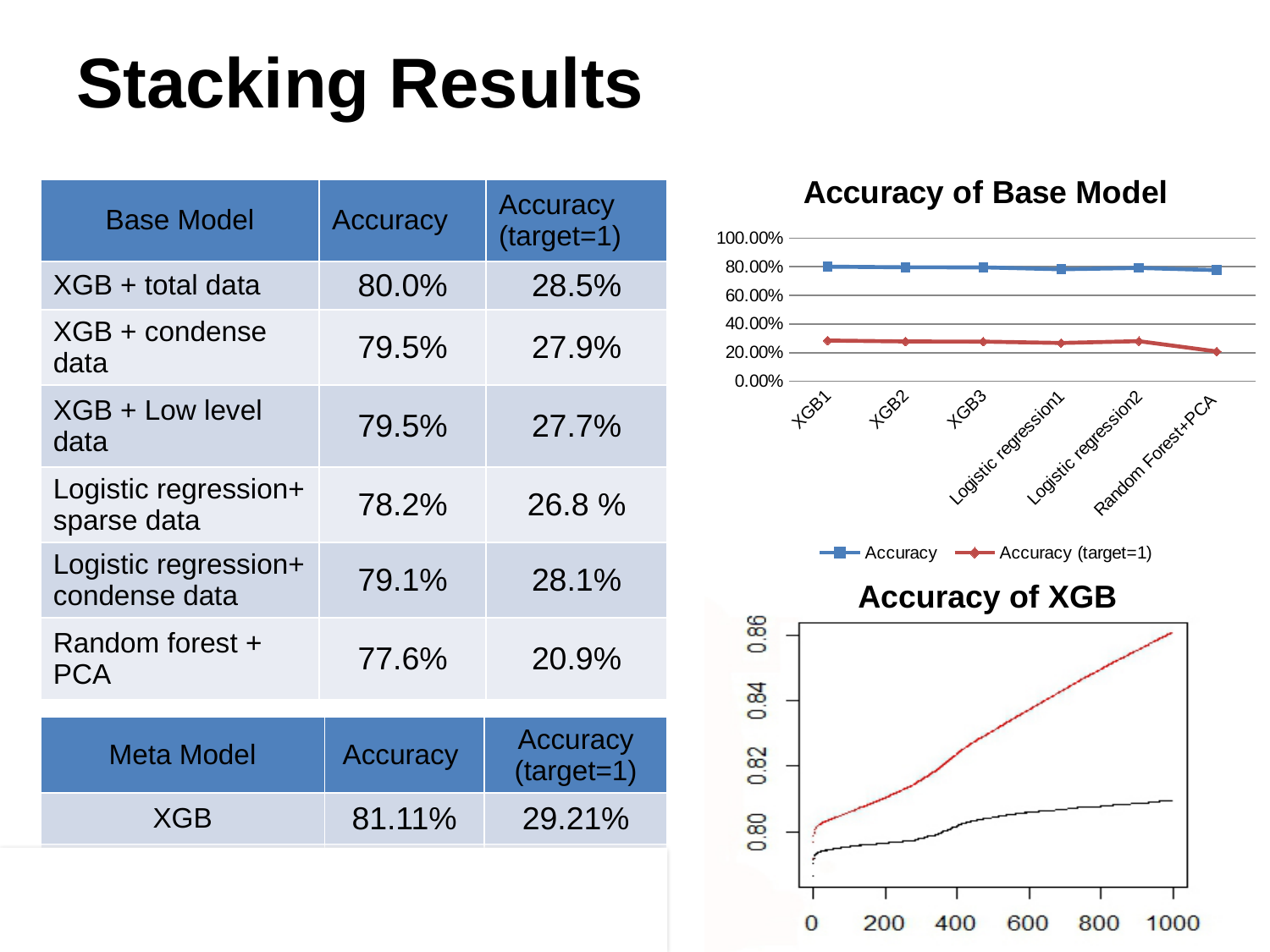
In the "Accuracy of XGB" chart, does the red line rise or fall as the x axis increases from 0 to 1000? rise In the "Accuracy of XGB" chart, is the black line's value at x = 1000 greater or less than 0.82? less In the "Accuracy of Base Model" chart, which series is higher for XGB2: Accuracy or Accuracy (target=1)? Accuracy What is the title of the chart in the lower right of the slide? Accuracy of XGB How many series does the legend of the "Accuracy of Base Model" chart list? 2 In the "Accuracy of Base Model" chart, which category has the lowest Accuracy (target=1) value? Random Forest+PCA In the "Accuracy of Base Model" chart, what colour is the Accuracy (target=1) line? red In the "Accuracy of XGB" chart, is the red line's value at x = 1000 greater or less than 0.84? greater What kind of chart is the "Accuracy of Base Model" chart? line chart How many categories are shown on the x axis of the "Accuracy of Base Model" chart? 6 In the "Accuracy of Base Model" chart, is the Accuracy value for XGB1 greater or less than 60.00%? greater